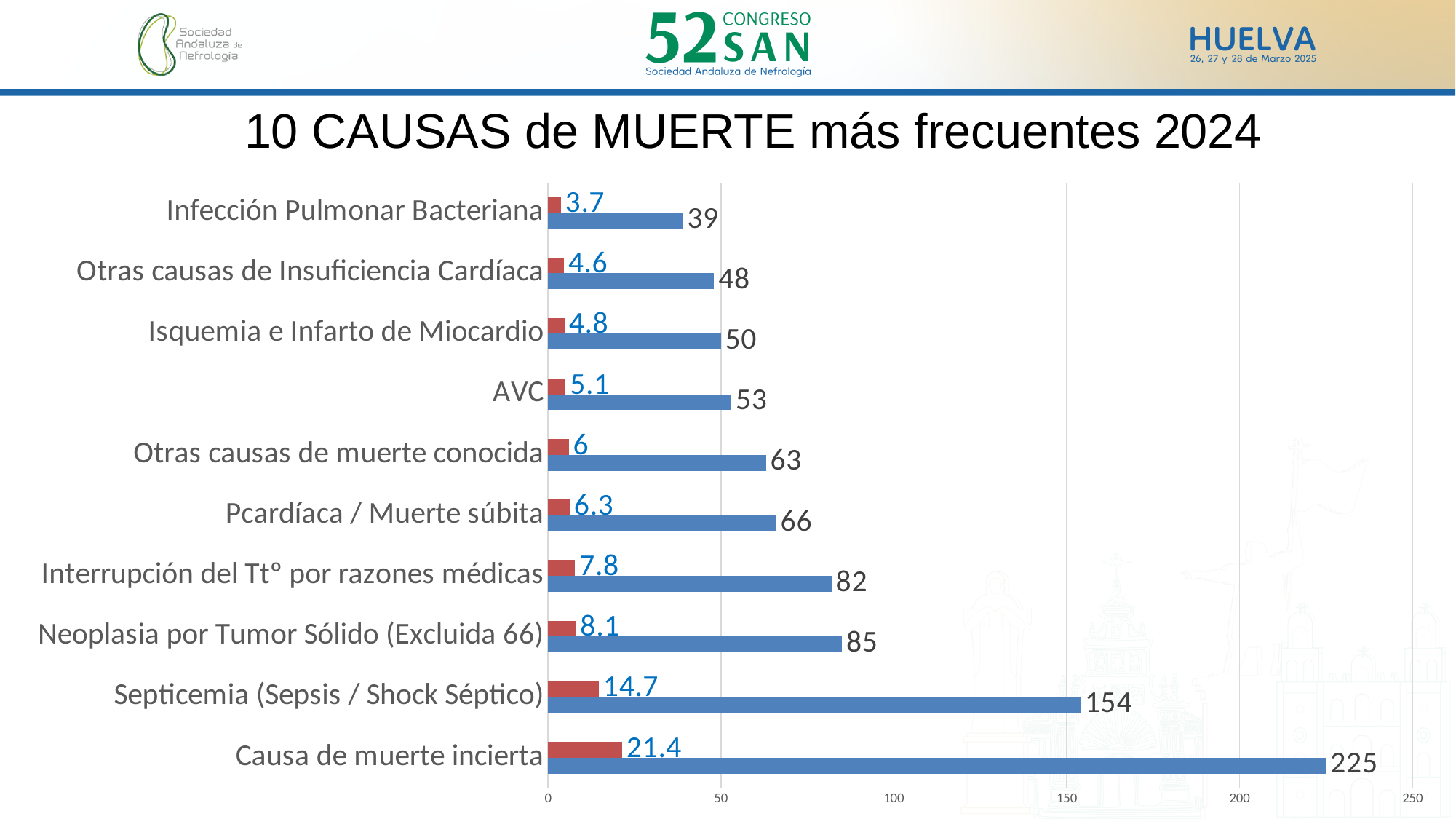
What kind of chart is shown on the slide? bar chart What is the value of the red bar for Neoplasia por Tumor Sólido (Excluida 66)? 8.1 Which cause of death has the lowest blue bar value? Infección Pulmonar Bacteriana What is the value of the blue bar for Septicemia (Sepsis / Shock Séptico)? 154 Which has a larger blue bar value, Interrupción del Ttº por razones médicas or Pcardíaca / Muerte súbita? Interrupción del Ttº por razones médicas What is the title of the chart on the slide? 10 CAUSAS de MUERTE más frecuentes 2024 Is the blue bar value for Neoplasia por Tumor Sólido (Excluida 66) greater or less than 100? less What is the value of the red bar for Causa de muerte incierta? 21.4 Which cause of death has the highest blue bar value? Causa de muerte incierta How many causes of death are listed on the chart? 10 What is the value of the blue bar for AVC? 53 What is the difference between the blue bar values for Causa de muerte incierta and Septicemia (Sepsis / Shock Séptico)? 71